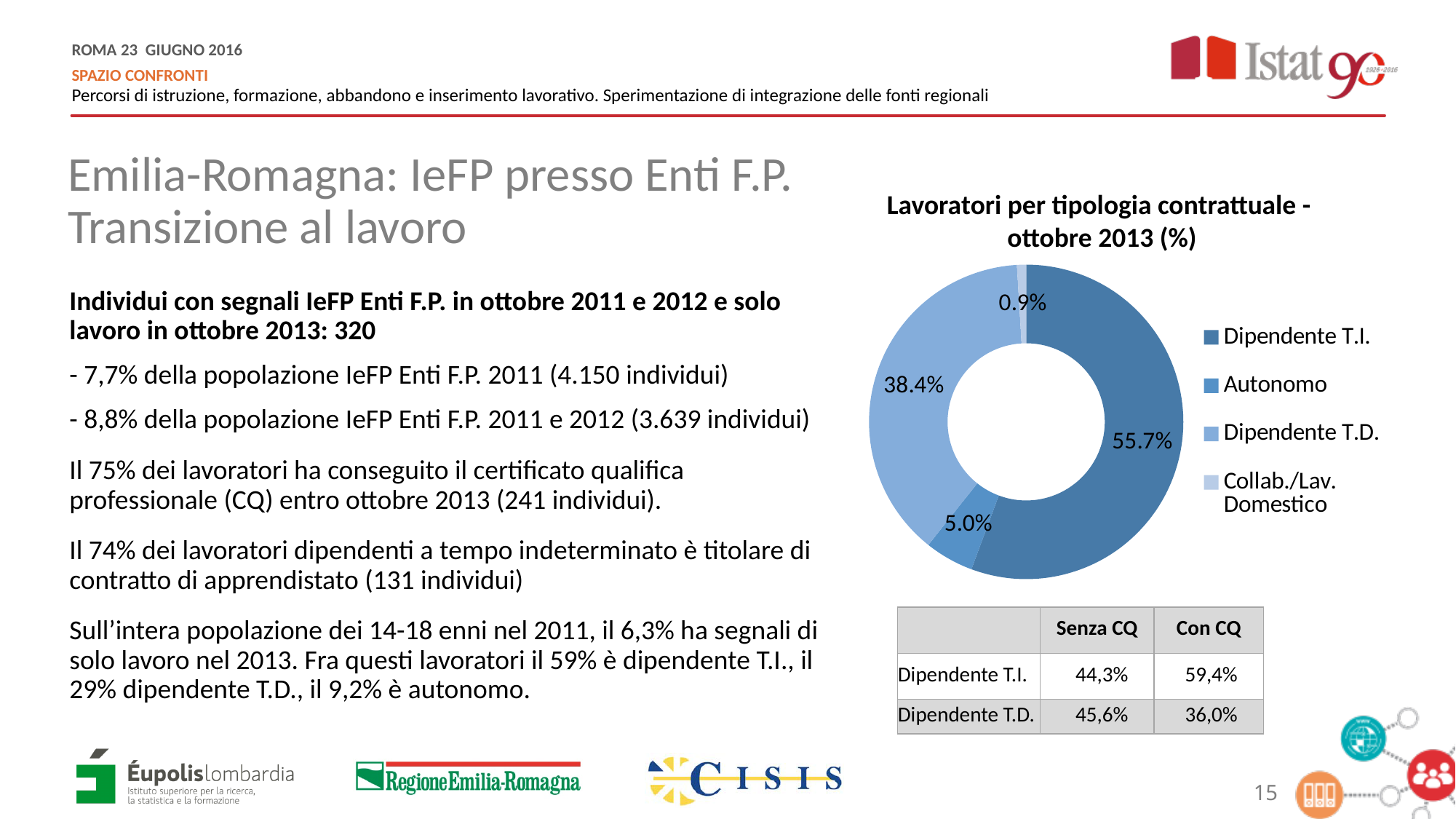
What share of workers are Dipendente T.I. in the chart 'Lavoratori per tipologia contrattuale - ottobre 2013 (%)'? 55.7% Which contract type has the largest share in the chart? Dipendente T.I. What is the title of the chart on the slide? Lavoratori per tipologia contrattuale - ottobre 2013 (%) What percentage is shown for Collab./Lav. Domestico in the chart? 0.9% What is the difference between the Autonomo and Collab./Lav. Domestico shares in the chart? 4.1 percentage points By how many percentage points does Dipendente T.I. exceed Dipendente T.D. in the chart? 17.3 percentage points What percentage of workers are Dipendente T.D. according to the doughnut chart? 38.4% What is the value shown for Autonomo in the chart? 5.0% Which contract type has the smallest share in the chart? Collab./Lav. Domestico How many contract categories are shown in the chart? 4 Which is larger in the chart: the share for Autonomo or the share for Dipendente T.D.? Dipendente T.D. What type of chart is used to show 'Lavoratori per tipologia contrattuale - ottobre 2013 (%)'? Doughnut (pie) chart